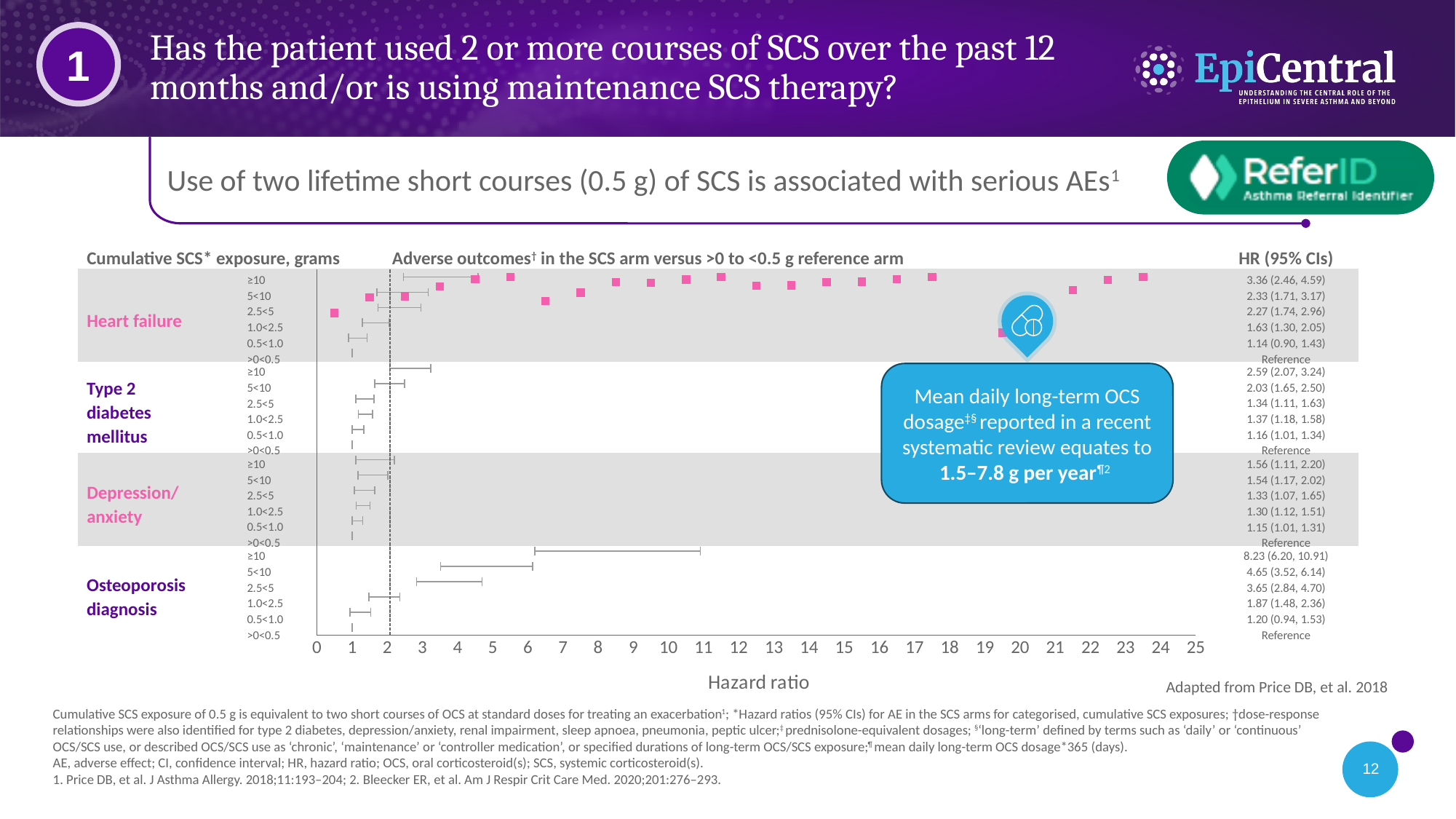
What is the difference between the hazard ratios for osteoporosis diagnosis at ≥10 grams and at 5<10 grams? 3.58 What is the hazard ratio (95% CI) for depression/anxiety at a cumulative SCS exposure of 0.5<1.0 grams? 1.15 (1.01, 1.31) Does the hazard ratio for osteoporosis diagnosis rise or fall as cumulative SCS exposure increases? Rises Is the hazard ratio for osteoporosis diagnosis at ≥10 grams greater or less than 5? greater How many cumulative SCS exposure categories are listed for each adverse outcome? 6 What is the hazard ratio (95% CI) for heart failure at a cumulative SCS exposure of ≥10 grams? 3.36 (2.46, 4.59) At the 5<10 grams exposure level, which has the larger hazard ratio: heart failure or type 2 diabetes mellitus? Heart failure What is the label of the horizontal axis of the chart? Hazard ratio Which adverse outcome has the highest hazard ratio at the ≥10 grams exposure level? Osteoporosis diagnosis Which adverse outcome has the lowest hazard ratio at the ≥10 grams exposure level? Depression/anxiety What is the hazard ratio (95% CI) for osteoporosis diagnosis at a cumulative SCS exposure of ≥10 grams? 8.23 (6.20, 10.91) How many adverse outcomes are shown in the forest plot? 4